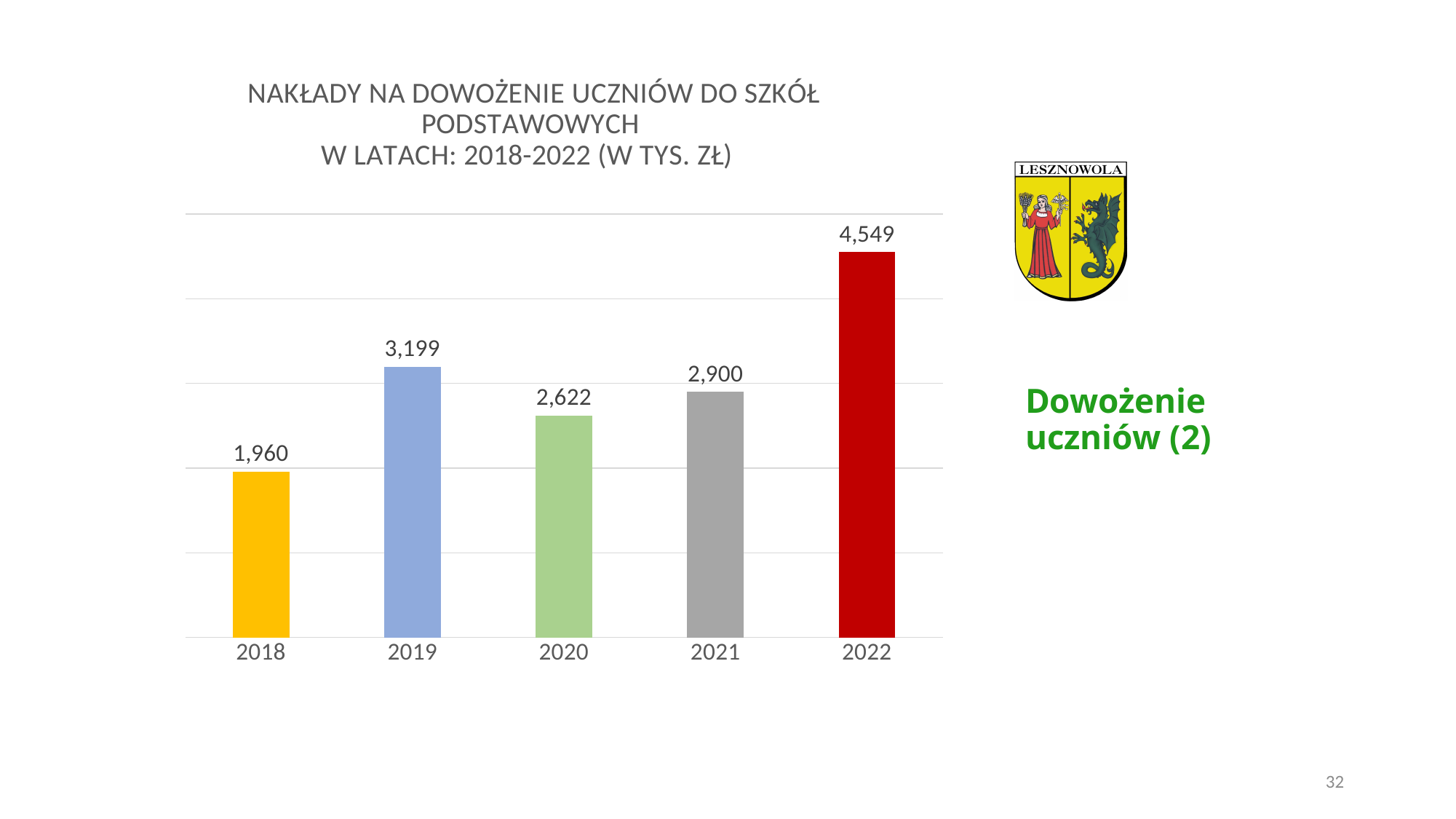
What is the difference between the values for 2019 and 2018? 1,239 How many years are shown on the x axis? 5 What colour is the bar for 2022? red What is the value for 2018? 1,960 What is the difference between the values for 2022 and 2021? 1,649 Which year has the highest value? 2022 What is the value for 2022? 4,549 Does the value rise or fall from 2019 to 2020? fall Which is larger, the value for 2019 or the value for 2020? 2019 What is the value for 2020? 2,622 Which year has the lowest value? 2018 What kind of chart is this? bar chart